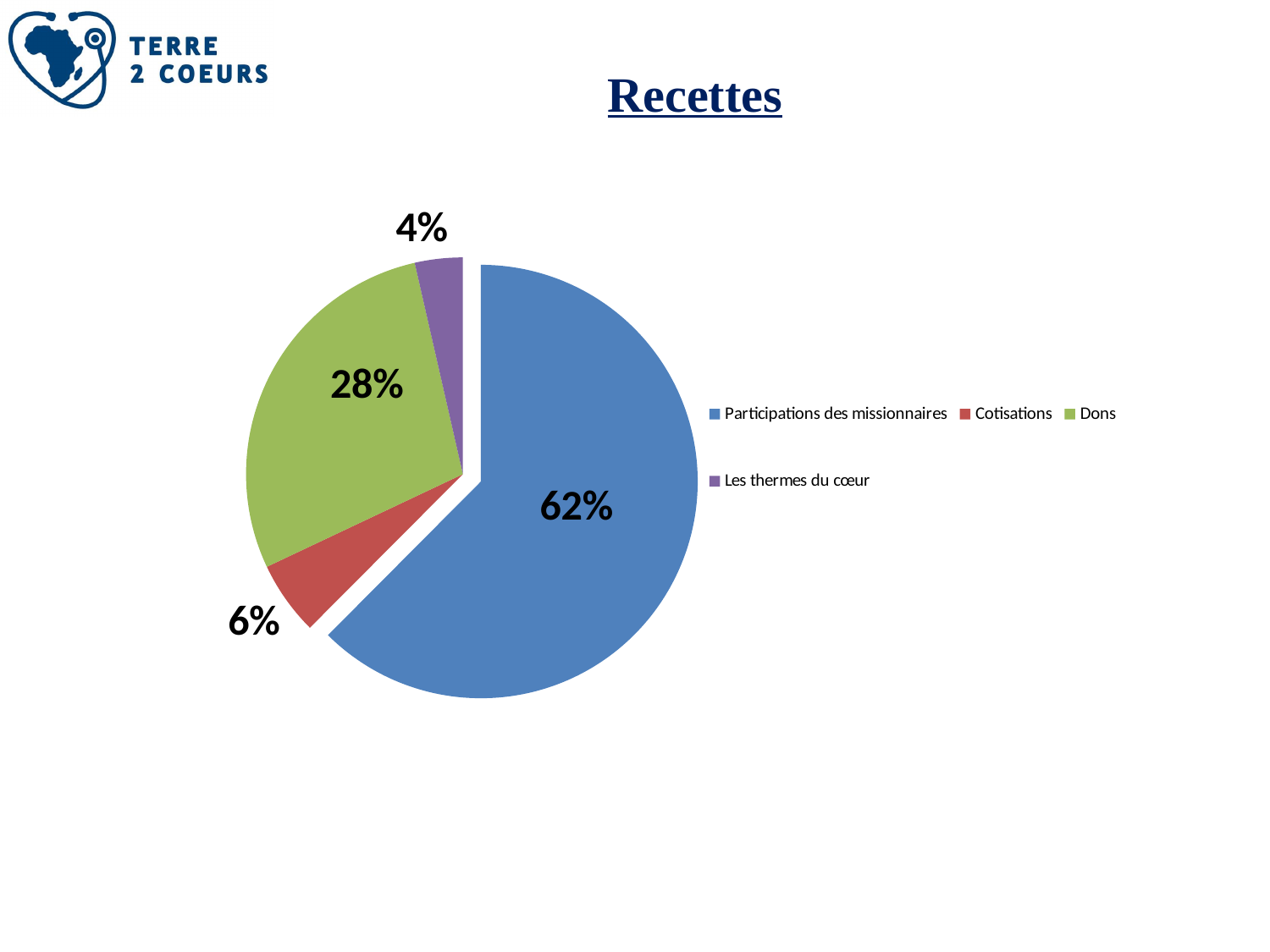
What is the title of the slide containing the pie chart? Recettes What share of the pie does Cotisations represent? 6% What share of the pie does Participations des missionnaires represent? 62% How many slices does the pie chart have? 4 Which is larger, the share for Cotisations or the share for Les thermes du cœur? Cotisations What share of the pie does Les thermes du cœur represent? 4% What colour is the slice for Dons? green Which category has the smallest slice of the pie? Les thermes du cœur Which category has the largest slice of the pie? Participations des missionnaires What is the difference in percentage points between Participations des missionnaires and Dons? 34 What kind of chart is shown on the slide? pie chart